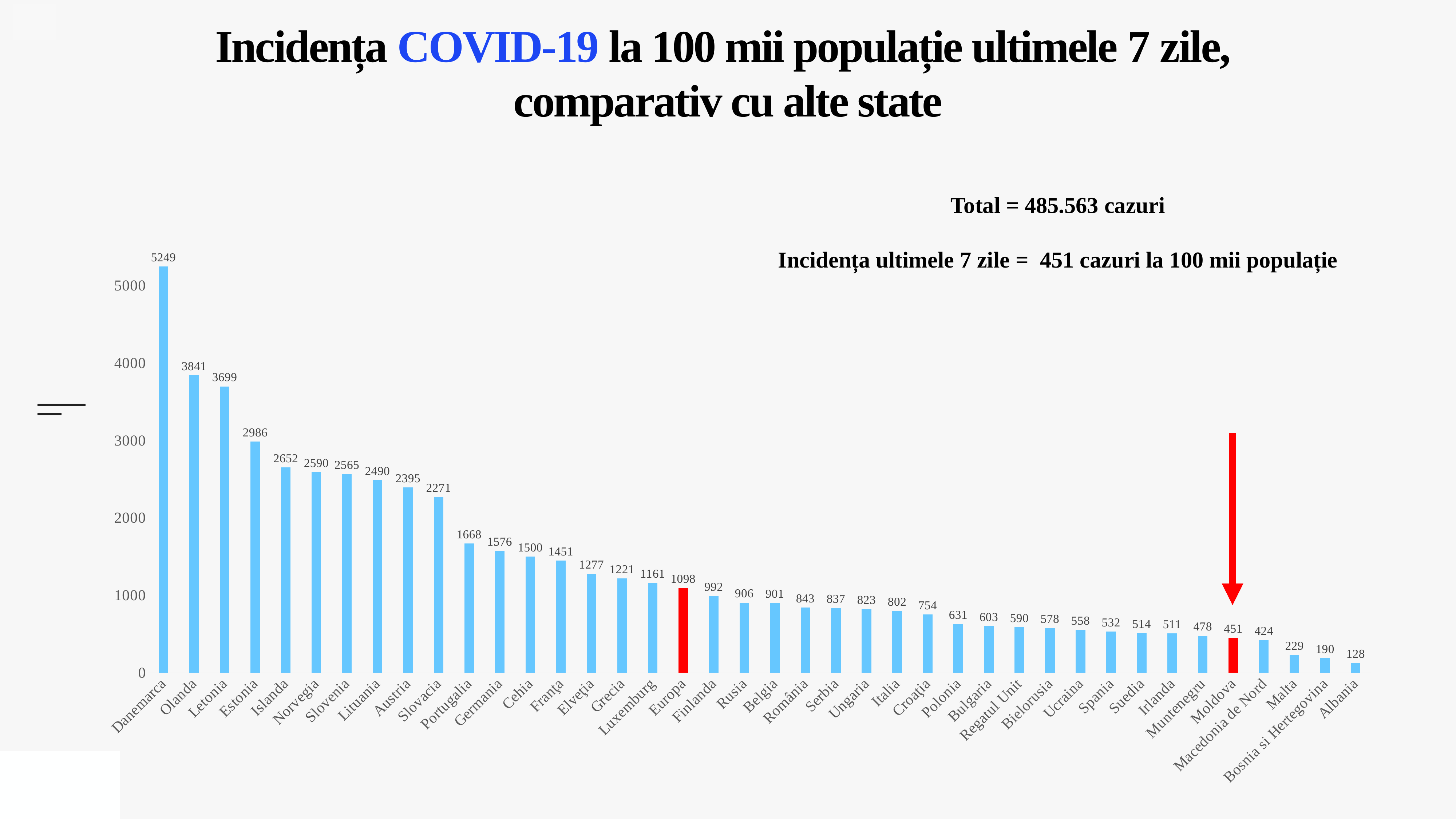
What kind of chart is shown on the slide? Bar chart What is the value for Moldova? 451 What is the difference between the values for Olanda and Letonia? 142 Which has a larger value, Estonia or Islanda? Estonia What is the value for Europa? 1098 What is the value for Danemarca? 5249 What is the value for România? 843 Which bars are coloured red instead of blue? Europa and Moldova Which country has the lowest value? Albania Which country has the highest value? Danemarca What is the difference between the values for Europa and Moldova? 647 How many countries/categories are shown on the x axis? 40